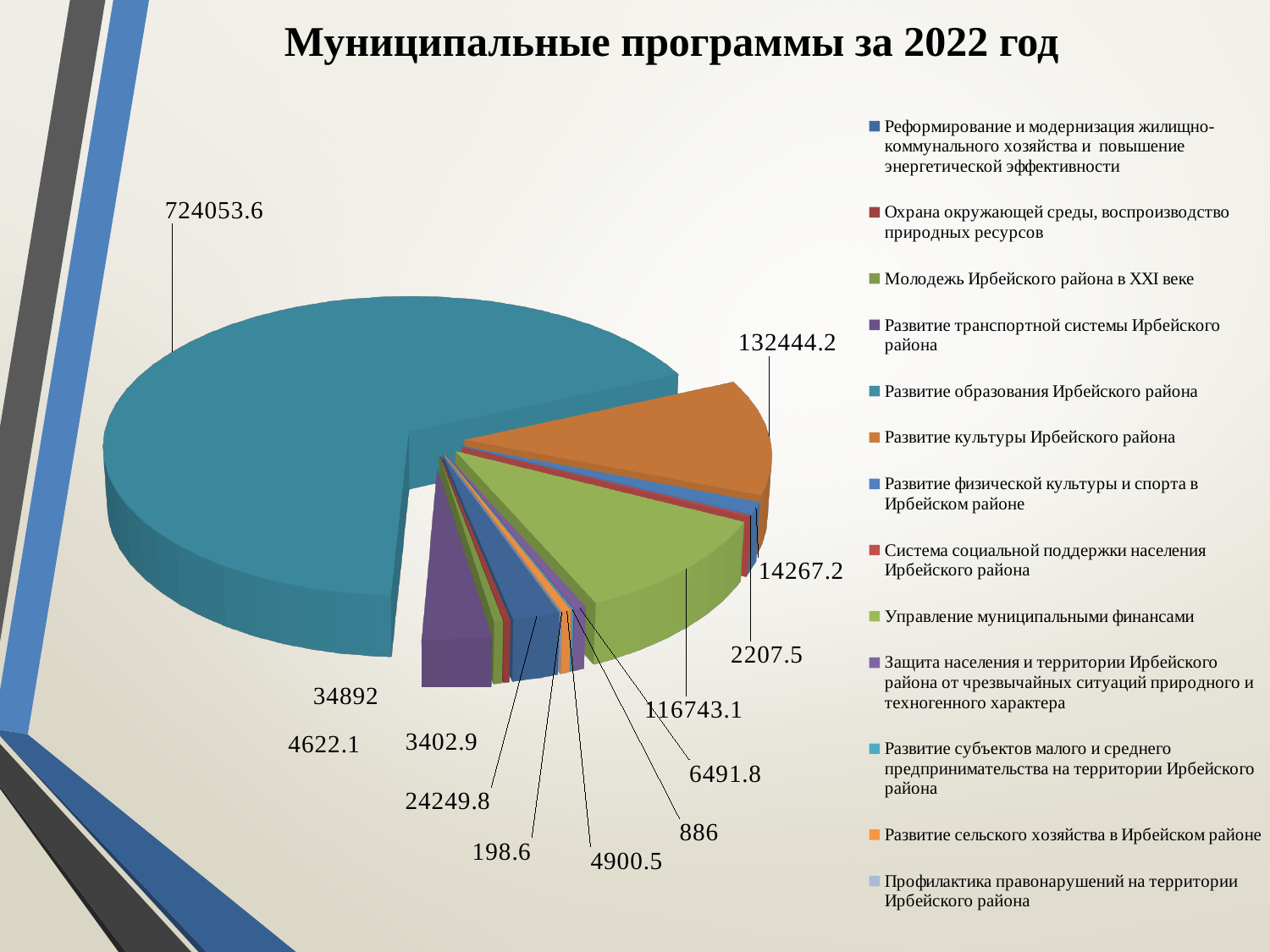
What is the value for Развитие образования Ирбейского района? 724053.6 Which category does the orange slice represent? Развитие культуры Ирбейского района What is the difference between the values for Развитие образования Ирбейского района and Развитие культуры Ирбейского района? 591609.4 How many data labels are shown on the pie chart? 13 What is the value for Управление муниципальными финансами? 116743.1 How many entries does the chart legend list? 13 What type of chart is shown on the slide? Pie chart What is the title of the chart? Муниципальные программы за 2022 год Which category has the largest slice of the pie? Развитие образования Ирбейского района Which is larger: Развитие культуры Ирбейского района or Управление муниципальными финансами? Развитие культуры Ирбейского района What is the smallest value labelled on the pie chart? 198.6 What is the value for Развитие культуры Ирбейского района? 132444.2